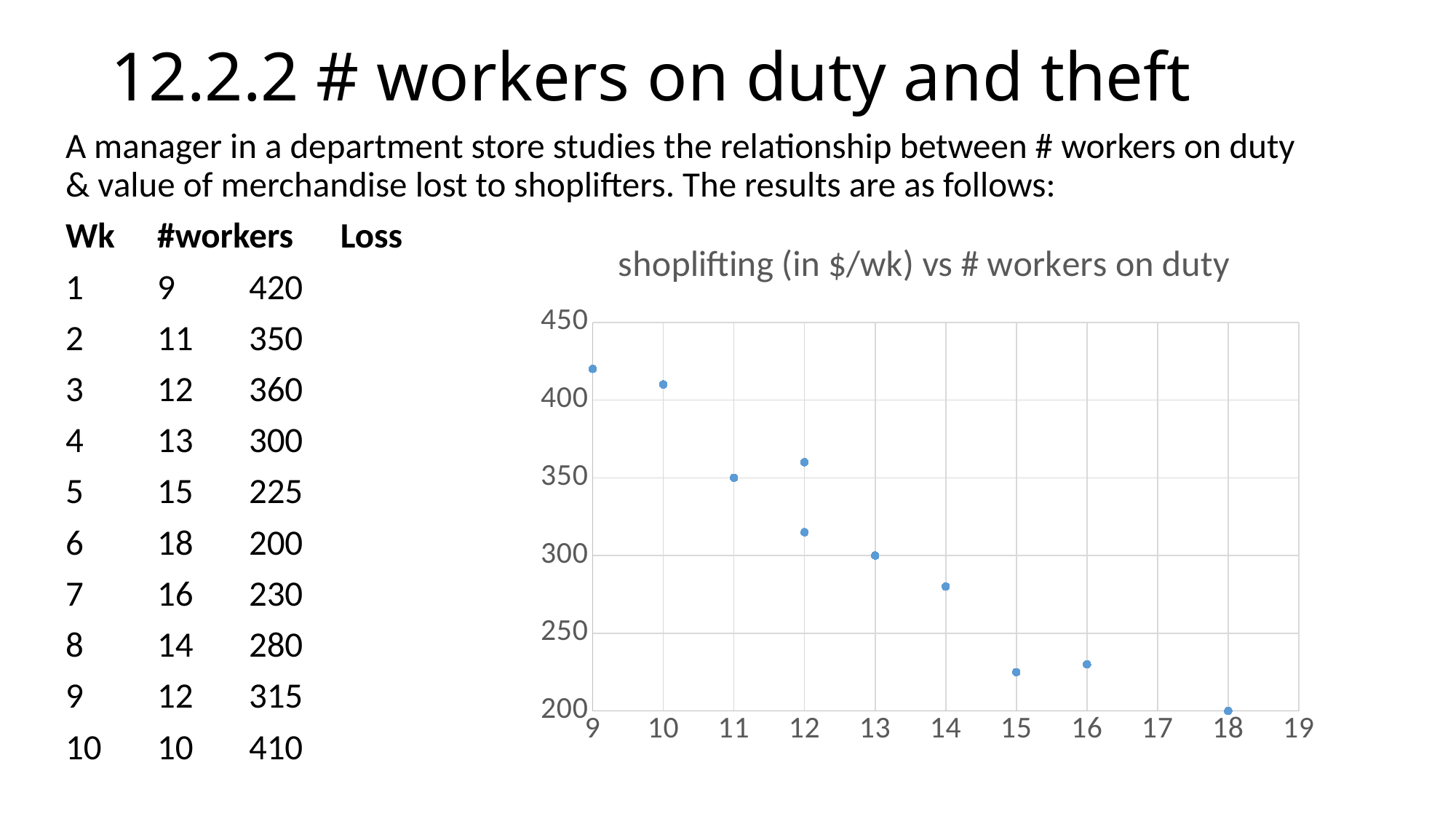
As the number of workers on duty increases along the x axis, does the shoplifting loss generally rise or fall? fall What is the shoplifting loss for the week with 9 workers on duty? 420 Is the shoplifting loss for 15 workers on duty greater or less than 250? less At which number of workers on duty is the shoplifting loss highest? 9 What is the shoplifting loss for the week with 18 workers on duty? 200 What is the title of the chart? shoplifting (in $/wk) vs # workers on duty At which number of workers on duty is the shoplifting loss lowest? 18 What is the difference between the highest shoplifting loss (9 workers) and the lowest (18 workers)? 220 Is the shoplifting loss for 10 workers on duty greater or less than 400? greater Which has the larger shoplifting loss: 11 workers on duty or 13 workers on duty? 11 workers on duty How many data points are plotted in the chart? 10 What kind of chart is shown on the slide? scatter chart